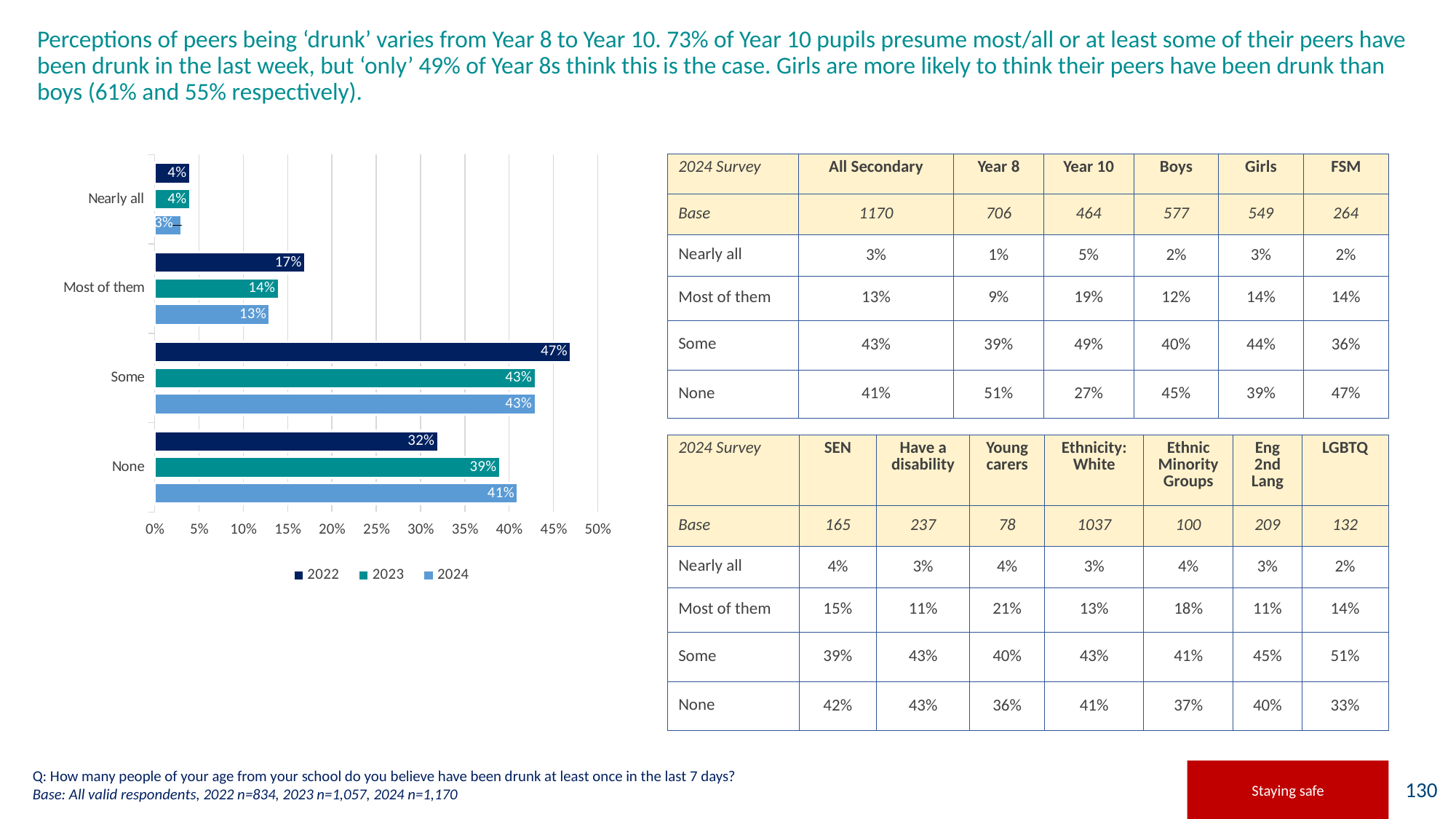
Which series is shown in the darkest blue in the chart legend? 2022 What is the difference between the 2022 and 2024 values for 'None' in the chart? 9% What is the 2023 value for 'Most of them' in the chart? 14% What is the 2024 value for 'None' in the chart? 41% What kind of chart is shown on the slide? bar chart How many series does the chart legend list? 3 How many categories are shown on the chart? 4 Which category has the lowest 2024 value in the chart? Nearly all What is the 2022 value for 'Some' in the chart? 47% For 'Most of them', which series has the larger value, 2022 or 2024? 2022 Which category has the highest 2022 value in the chart? Some Is the 2023 value for 'None' greater or less than 35%? greater